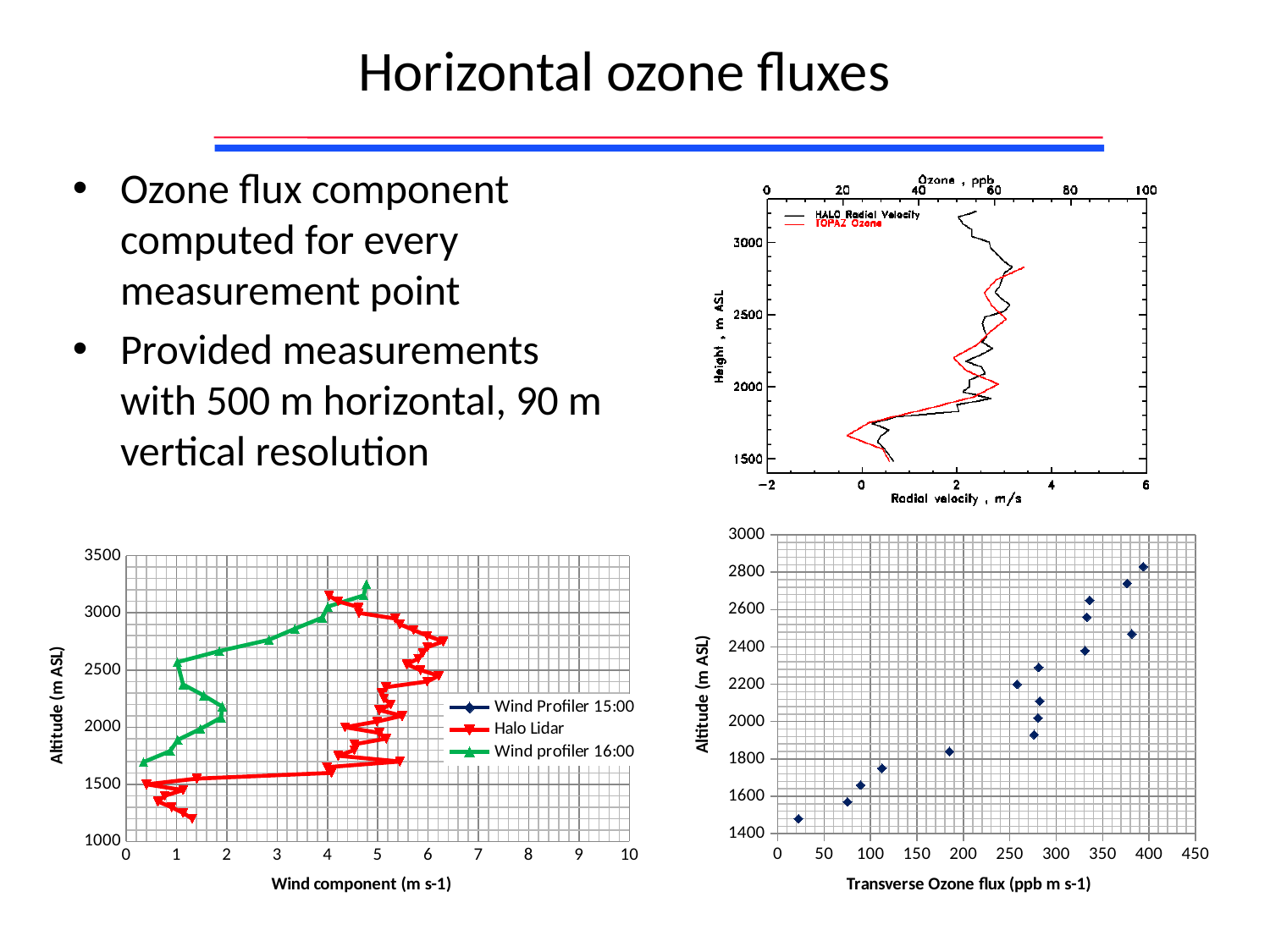
How many series does the legend of the top-right chart (HALO Radial Velocity / TOPAZ Ozone) list? 2 How many data points are plotted in the bottom-right chart (Transverse Ozone flux)? 16 In the bottom-left chart (Wind component), is the Halo Lidar wind component at about 2750 m altitude greater or less than 5? greater In the bottom-right chart (Transverse Ozone flux), does the transverse ozone flux generally increase or decrease with altitude? increase What kind of chart is the bottom-left chart (Wind component)? line chart In the bottom-right chart (Transverse Ozone flux), is the flux at the lowest plotted altitude greater or less than 50? less In the bottom-left chart (Wind component), at about 2750 m altitude, which series has the larger wind component: Halo Lidar or Wind profiler 16:00? Halo Lidar What kind of chart is the bottom-right chart (Transverse Ozone flux)? scatter chart What is the x-axis title of the bottom-right chart? Transverse Ozone flux (ppb m s-1) What is the x-axis title of the bottom-left chart? Wind component (m s-1) How many series does the legend of the bottom-left chart (Wind component) list? 3 In the bottom-right chart (Transverse Ozone flux), is the flux at the highest plotted altitude greater or less than 350? greater